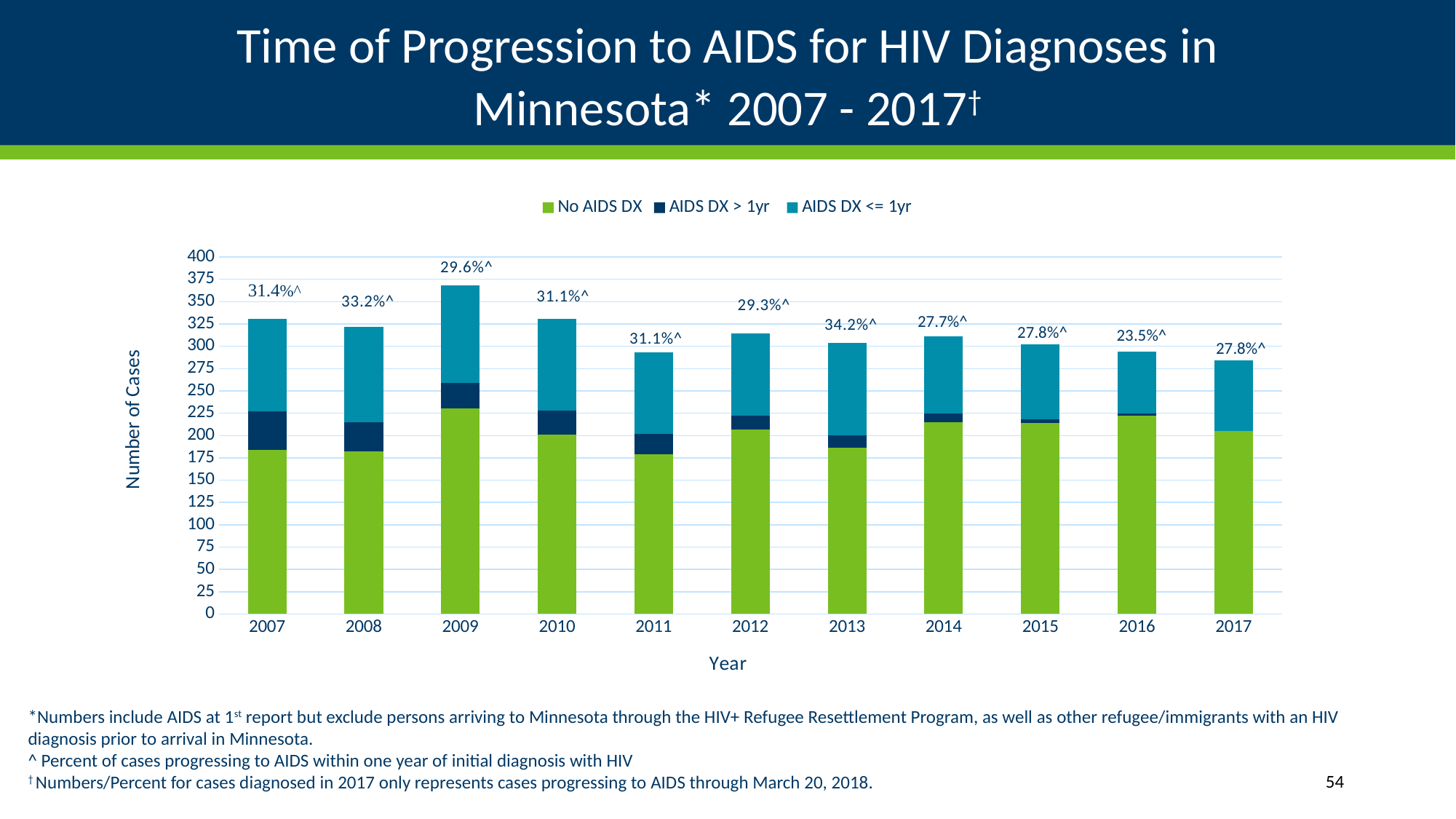
Which year has the larger percentage label, 2007 or 2008? 2008 Which year has the highest percentage of cases progressing to AIDS within one year? 2013 Which year has the lowest percentage of cases progressing to AIDS within one year? 2016 How many series does the legend list? 3 Is the total number of cases for 2011 greater or less than 300? less How many years are shown on the x axis? 11 What is the difference in percentage points between the 2013 label (34.2%) and the 2016 label (23.5%)? 10.7 percentage points Which year has the tallest stacked bar (most total cases)? 2009 What kind of chart is shown on the slide? Stacked bar chart What percentage label is shown above the 2016 bar? 23.5% What percentage label is shown above the 2009 bar? 29.6% Is the total number of cases for 2009 greater or less than 350? greater